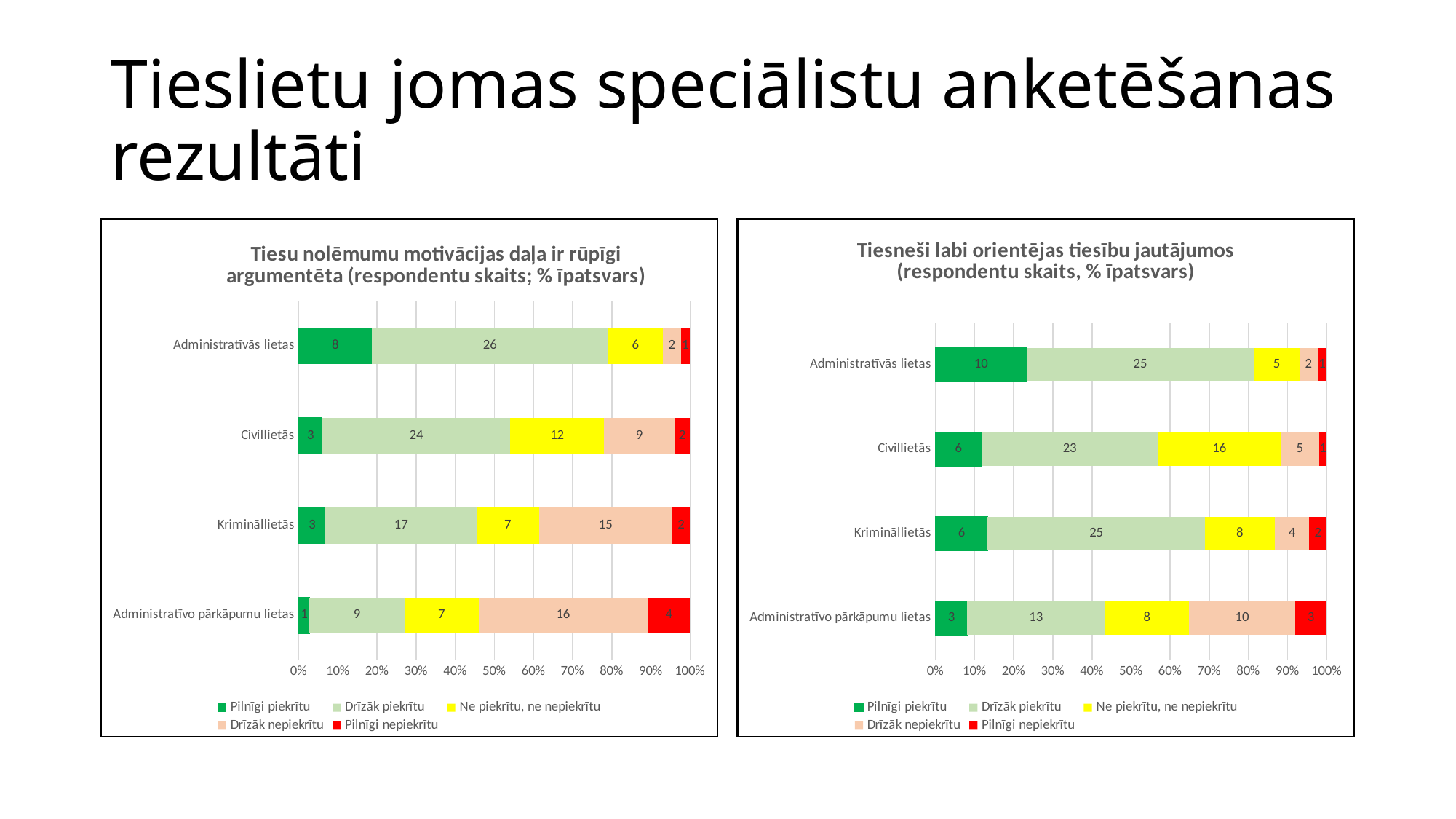
In the left chart, what is the total number of respondents for Civillietās? 50 In the left chart, how many respondents in Krimināllietās answered Drīzāk nepiekrītu? 15 In the left chart (Tiesu nolēmumu motivācijas daļa ir rūpīgi argumentēta), how many respondents in Administratīvās lietas answered Drīzāk piekrītu? 26 How many categories are shown on the y axis of the left chart? 4 In the right chart, how many respondents in Civillietās answered Ne piekrītu, ne nepiekrītu? 16 In the left chart, what is the difference between the Drīzāk nepiekrītu responses for Administratīvo pārkāpumu lietas and Civillietās? 7 In the right chart, which category has the lowest number of Drīzāk piekrītu responses? Administratīvo pārkāpumu lietas In the right chart (Tiesneši labi orientējas tiesību jautājumos), how many respondents in Administratīvās lietas answered Pilnīgi piekrītu? 10 How many series does the legend of the right chart list? 5 In the right chart, which is larger: the Pilnīgi piekrītu count for Krimināllietās or for Administratīvo pārkāpumu lietas? Krimināllietās In the right chart, what is the total number of respondents for Administratīvo pārkāpumu lietas? 37 In the left chart, which category has the highest number of Pilnīgi nepiekrītu responses? Administratīvo pārkāpumu lietas